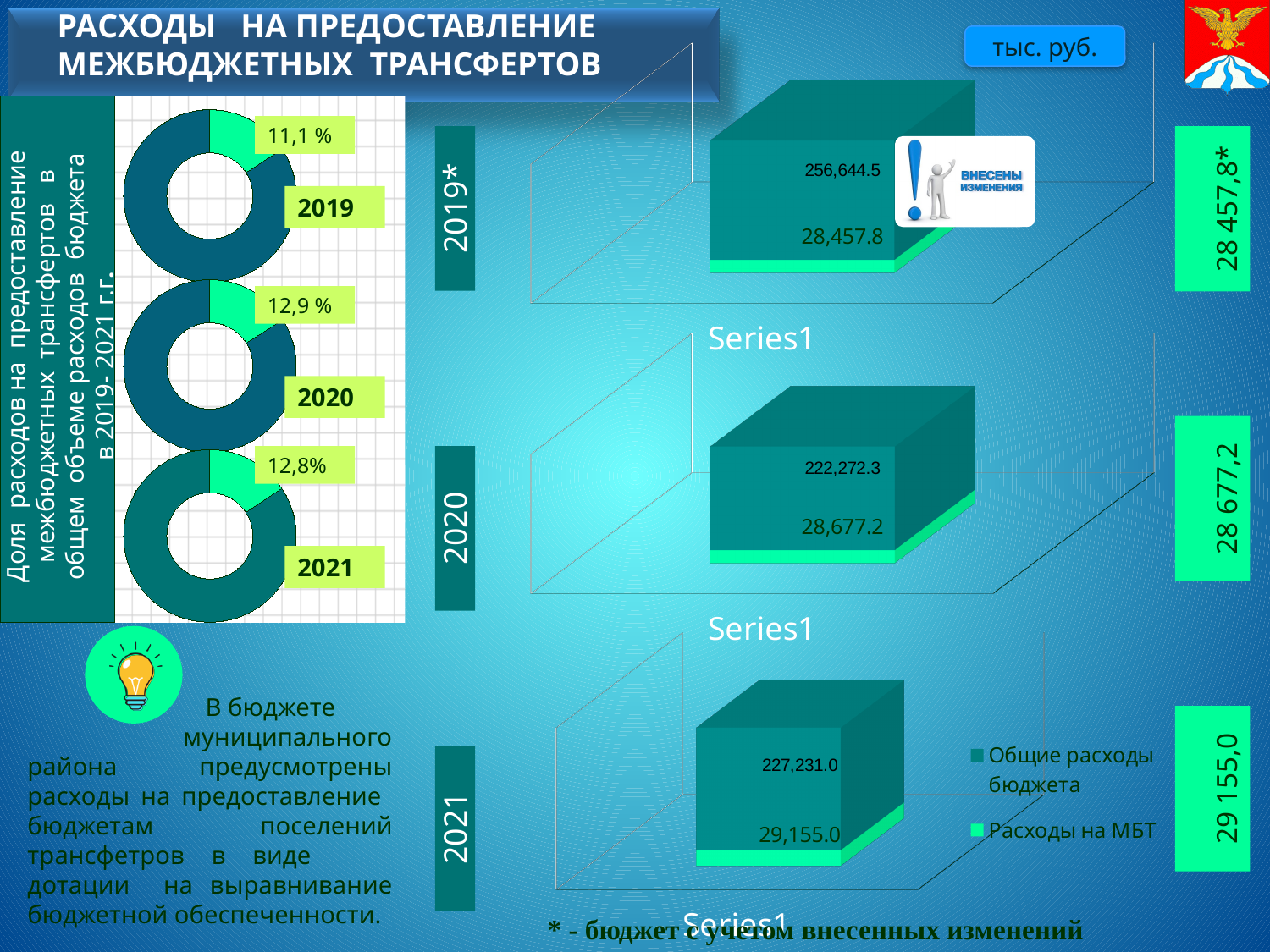
In the 3D bar chart for 2019*, what is the value labelled for Расходы на МБТ? 28,457.8 In the 3D bar chart for 2020, what is the value labelled for Общие расходы бюджета? 222,272.3 In the donut chart for 2020, what percentage is shown? 12,9 % In the 3D bar chart for 2021, what is the value labelled for Расходы на МБТ? 29,155.0 In the donut chart for 2019, what share of total budget expenditure is shown for intergovernmental transfers? 11,1 % Among the three donut charts (2019, 2020, 2021), which year shows the lowest share? 2019 How many series does the legend of the 3D bar charts list? 2 What type of chart is used to show the 2019, 2020 and 2021 percentage shares on the left of the slide? Donut chart In the 3D bar chart for 2019*, what is the value labelled for Общие расходы бюджета? 256,644.5 Comparing the 3D bar charts, which year has the larger value for Общие расходы бюджета: 2020 or 2021? 2021 In the donut chart for 2021, what percentage is shown? 12,8% Among the three donut charts (2019, 2020, 2021), which year shows the highest share? 2020